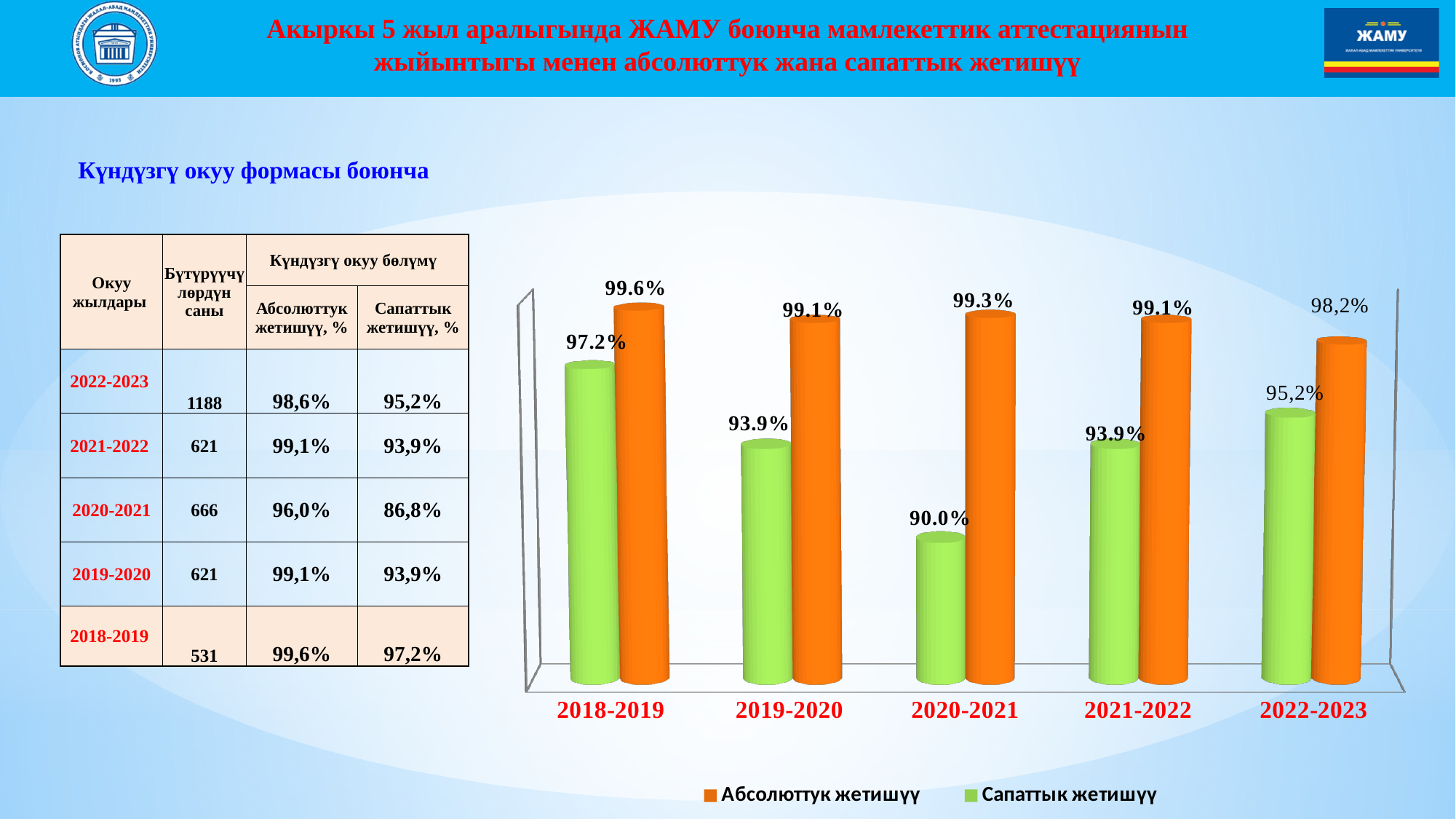
What type of chart is shown on the slide? Bar chart What is the value of Абсолюттук жетишүү for 2018-2019? 99.6% What is the value of Сапаттык жетишүү for 2022-2023? 95,2% Which is larger: Сапаттык жетишүү for 2018-2019 or for 2022-2023? 2018-2019 What is the difference between Абсолюттук жетишүү and Сапаттык жетишүү for 2020-2021? 9.3 percentage points How many series does the chart legend list? 2 Which academic year has the lowest Абсолюттук жетишүү value? 2022-2023 Which academic year has the lowest Сапаттык жетишүү value? 2020-2021 What is the value of Сапаттык жетишүү for 2020-2021? 90.0% How many academic years are shown on the x axis of the chart? 5 Which academic year has the highest Абсолюттук жетишүү value? 2018-2019 What is the value of Абсолюттук жетишүү for 2021-2022? 99.1%